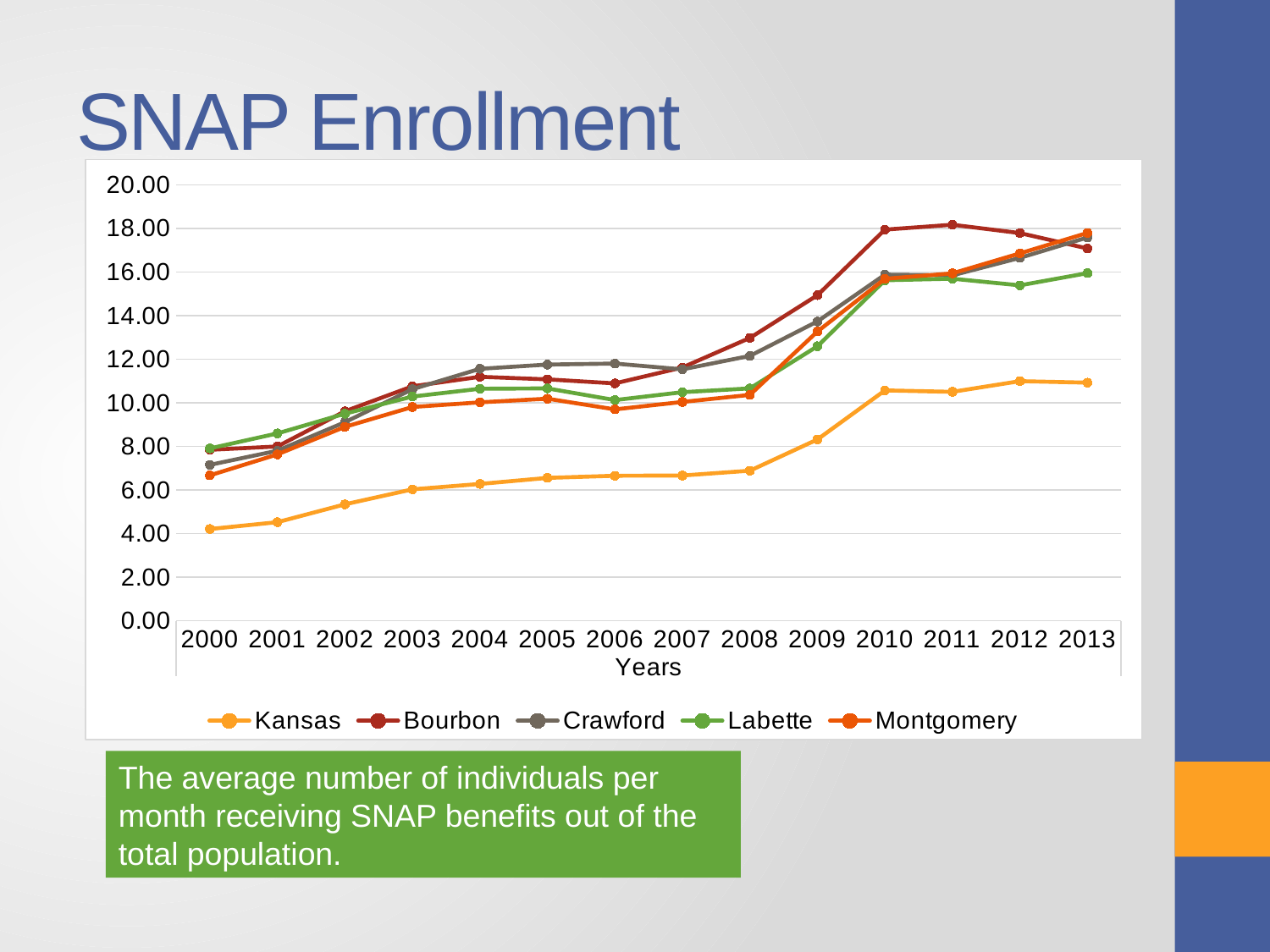
What kind of chart is shown on the slide? line chart Is the value for Bourbon in 2010 greater or less than 16.00? greater How many series does the legend list? 5 How many years are plotted along the x axis? 14 Is the value for Kansas in 2000 greater or less than 6.00? less Is the value for Labette in 2013 greater or less than 18.00? less Which series has the lowest value in 2013? Kansas Which series has the highest value in 2011? Bourbon In 2005, which is larger, the value for Kansas or the value for Bourbon? Bourbon What is the title of the x axis? Years Which series has the lowest value in 2000? Kansas Does the Kansas line rise or fall from 2000 to 2013? rise